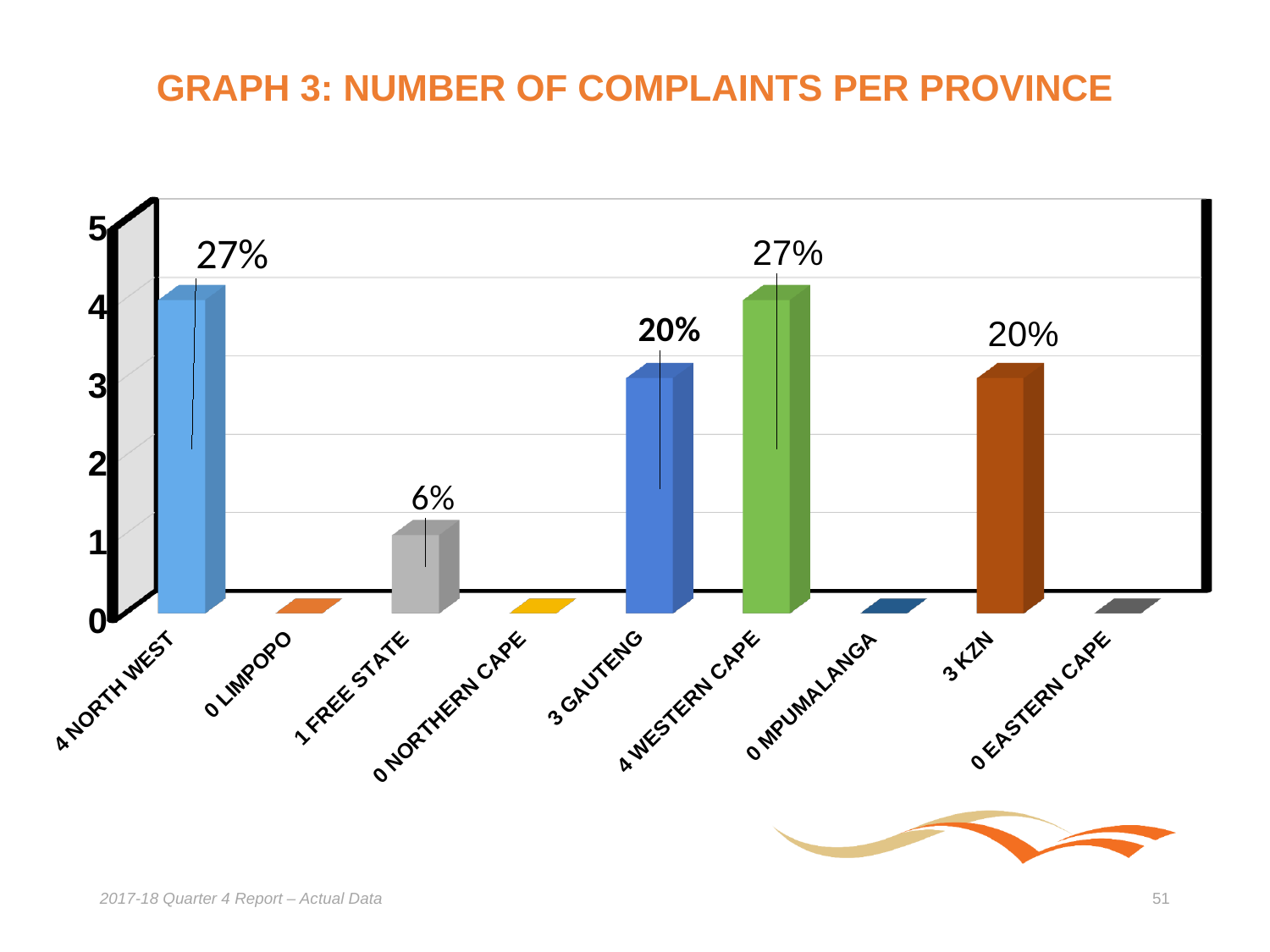
What is the title of the chart? GRAPH 3: NUMBER OF COMPLAINTS PER PROVINCE What percentage label is shown above the KZN bar? 20% Which province has the lowest non-zero number of complaints? Free State What percentage label is shown above the Free State bar? 6% What type of chart is shown on the slide? Bar chart How many provinces (categories) are shown on the x axis? 9 How many complaints are recorded for Gauteng? 3 How many complaints are recorded for Western Cape? 4 What is the difference in complaints between North West and Gauteng? 1 What percentage label is shown above the North West bar? 27% Which has more complaints, KZN or Free State? KZN How many provinces have 0 complaints? 4